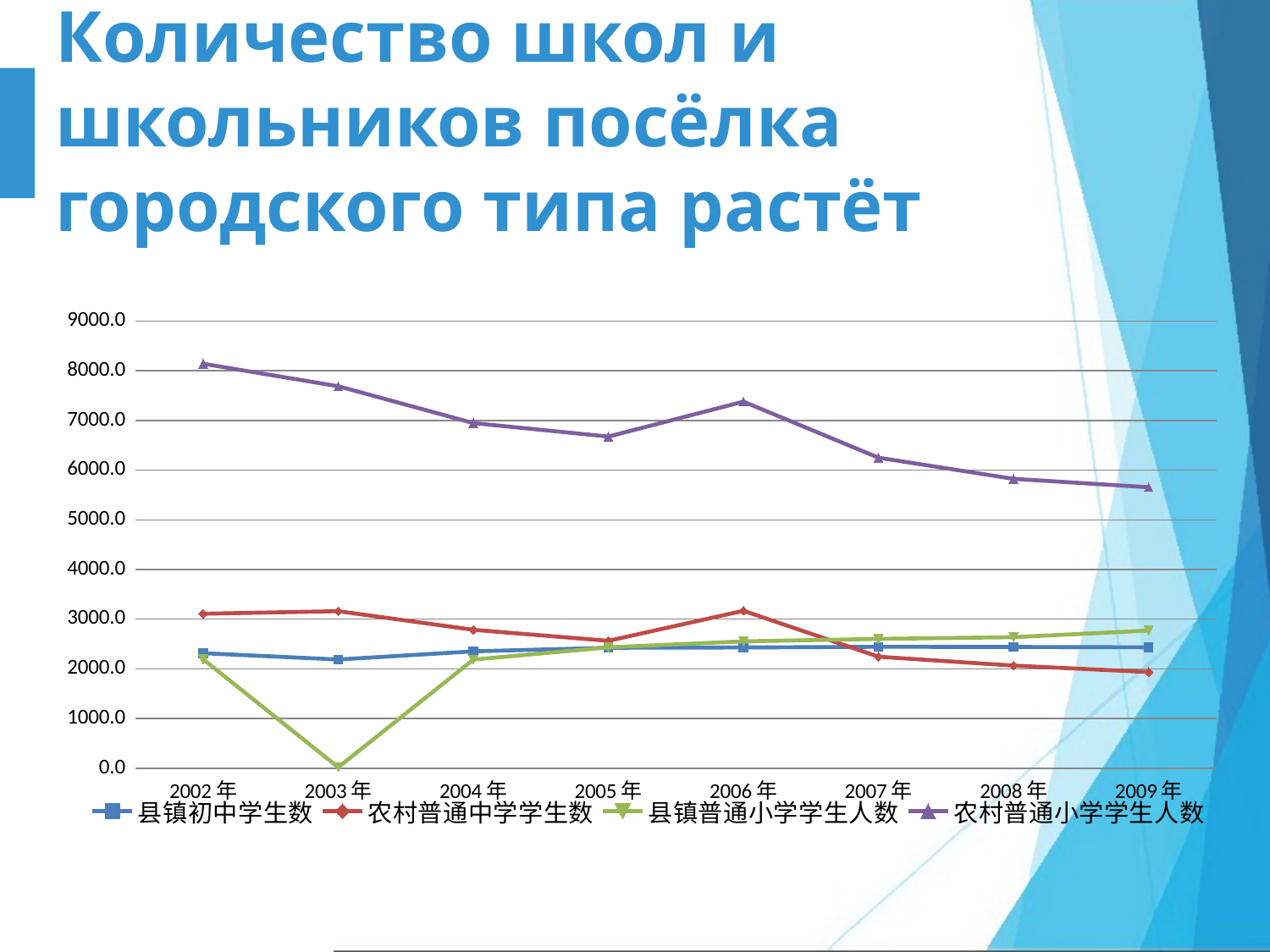
In which year is the 农村普通小学学生人数 series at its highest? 2002 年 In which year is the 县镇普通小学学生人数 series at its lowest? 2003 年 How many years are plotted along the x axis? 8 In 2009 年, which is larger: 县镇普通小学学生人数 or 农村普通中学学生数? 县镇普通小学学生人数 What kind of chart is shown on the slide? line chart Which series has the highest values across all years? 农村普通小学学生人数 Is the value for 县镇普通小学学生人数 in 2003 年 greater or less than 1000.0? less What colour is the line for 农村普通中学学生数? red Is the value for 农村普通小学学生人数 in 2009 年 greater or less than 6000.0? less Does the 县镇普通小学学生人数 series rise or fall from 2004 年 to 2009 年? rise How many series does the legend list? 4 Does the 农村普通小学学生人数 series generally rise or fall from 2002 年 to 2009 年? fall